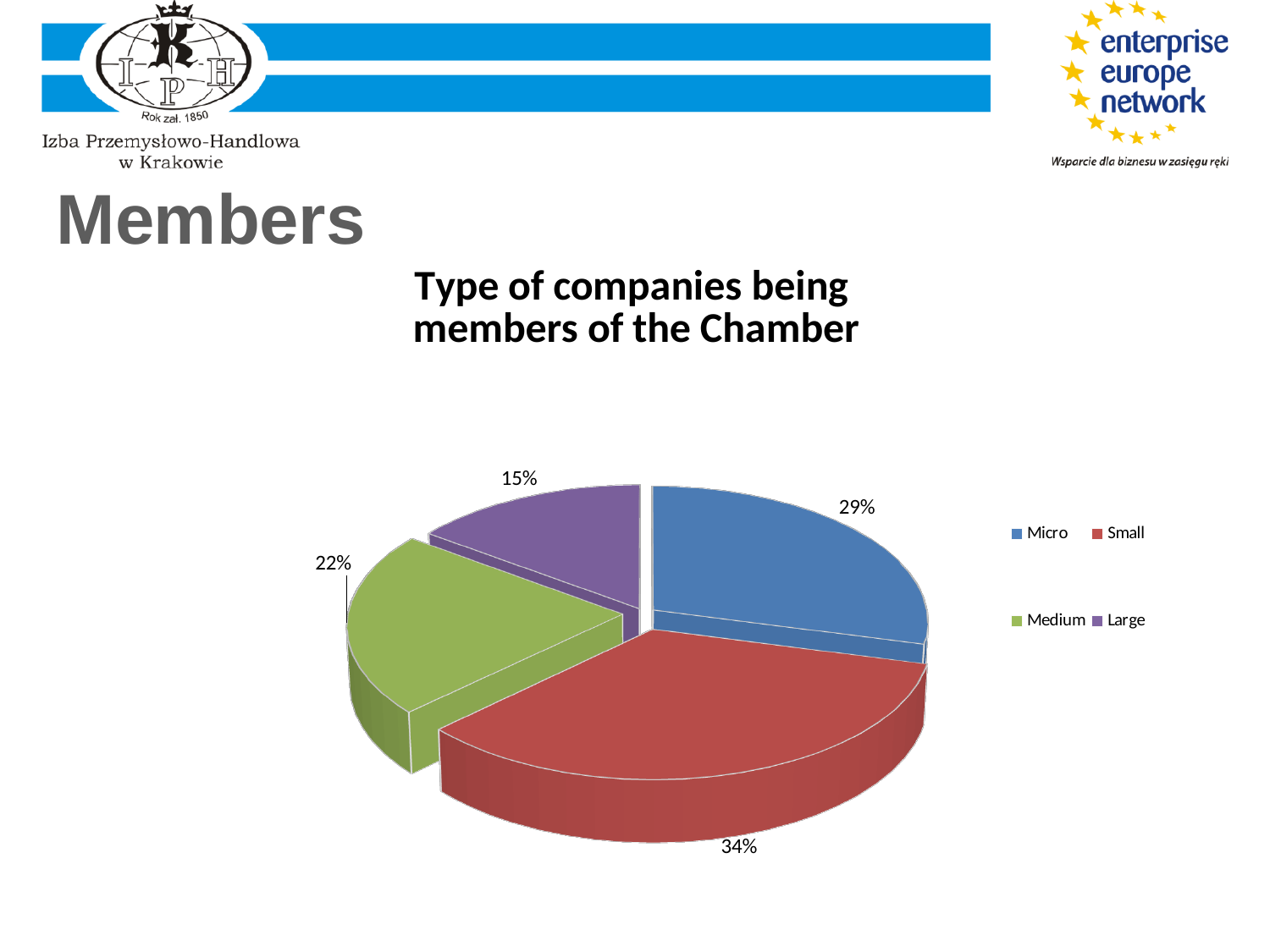
Which colour represents Medium in the pie chart? green Which has a larger share, Medium or Large? Medium What is the title of the chart? Type of companies being members of the Chamber What share of the pie is Large? 15% What is the difference between the shares for Small and Micro? 5% How many categories does the pie chart show? 4 What share of the pie is Small? 34% Which company type has the smallest share of the pie? Large What share of the pie is Medium? 22% Which company type has the largest share of the pie? Small What kind of chart is shown on the slide? pie chart What share of the pie is Micro? 29%